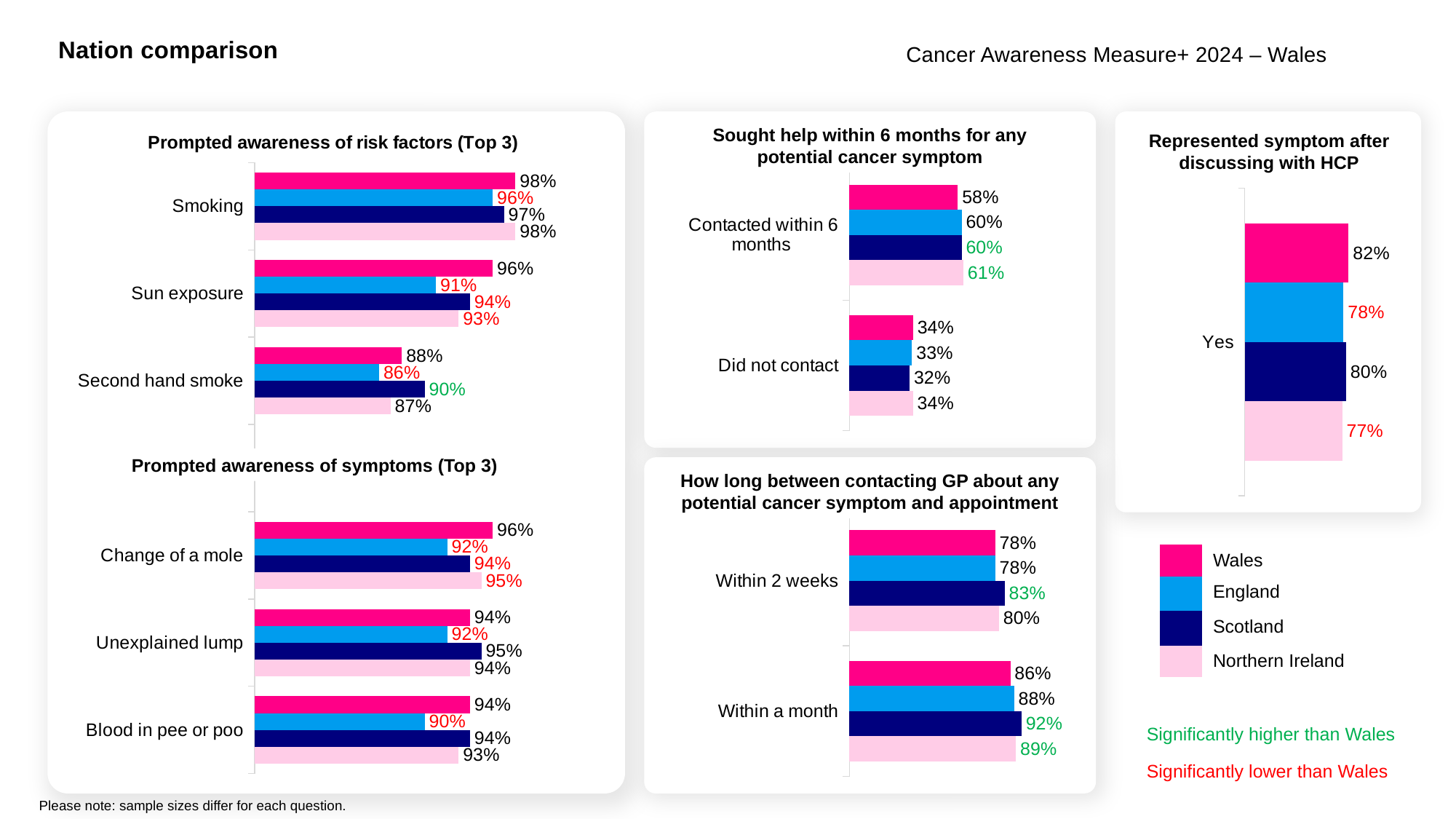
In the 'How long between contacting GP about any potential cancer symptom and appointment' chart, what is the difference between the Scotland and Wales values for Within 2 weeks? 5% What type of chart is 'Represented symptom after discussing with HCP'? bar chart In the 'Prompted awareness of risk factors (Top 3)' chart, what is the value for Scotland for Second hand smoke? 90% In the 'Represented symptom after discussing with HCP' chart, what is the value for Wales? 82% In the 'Prompted awareness of symptoms (Top 3)' chart, what is the difference between the Wales and England values for Blood in pee or poo? 4% In the 'Sought help within 6 months for any potential cancer symptom' chart, what is the value for Northern Ireland for Contacted within 6 months? 61% In the 'Prompted awareness of risk factors (Top 3)' chart, which nation has the lowest value for Sun exposure? England In the 'Prompted awareness of symptoms (Top 3)' chart, what is the value for Wales for Change of a mole? 96% In the 'How long between contacting GP about any potential cancer symptom and appointment' chart, which nation has the highest value for Within a month? Scotland In the 'Represented symptom after discussing with HCP' chart, is the value for England larger or smaller than the value for Scotland? smaller In the 'Sought help within 6 months for any potential cancer symptom' chart, which nation has the lowest value for Did not contact? Scotland How many series does the legend list? 4